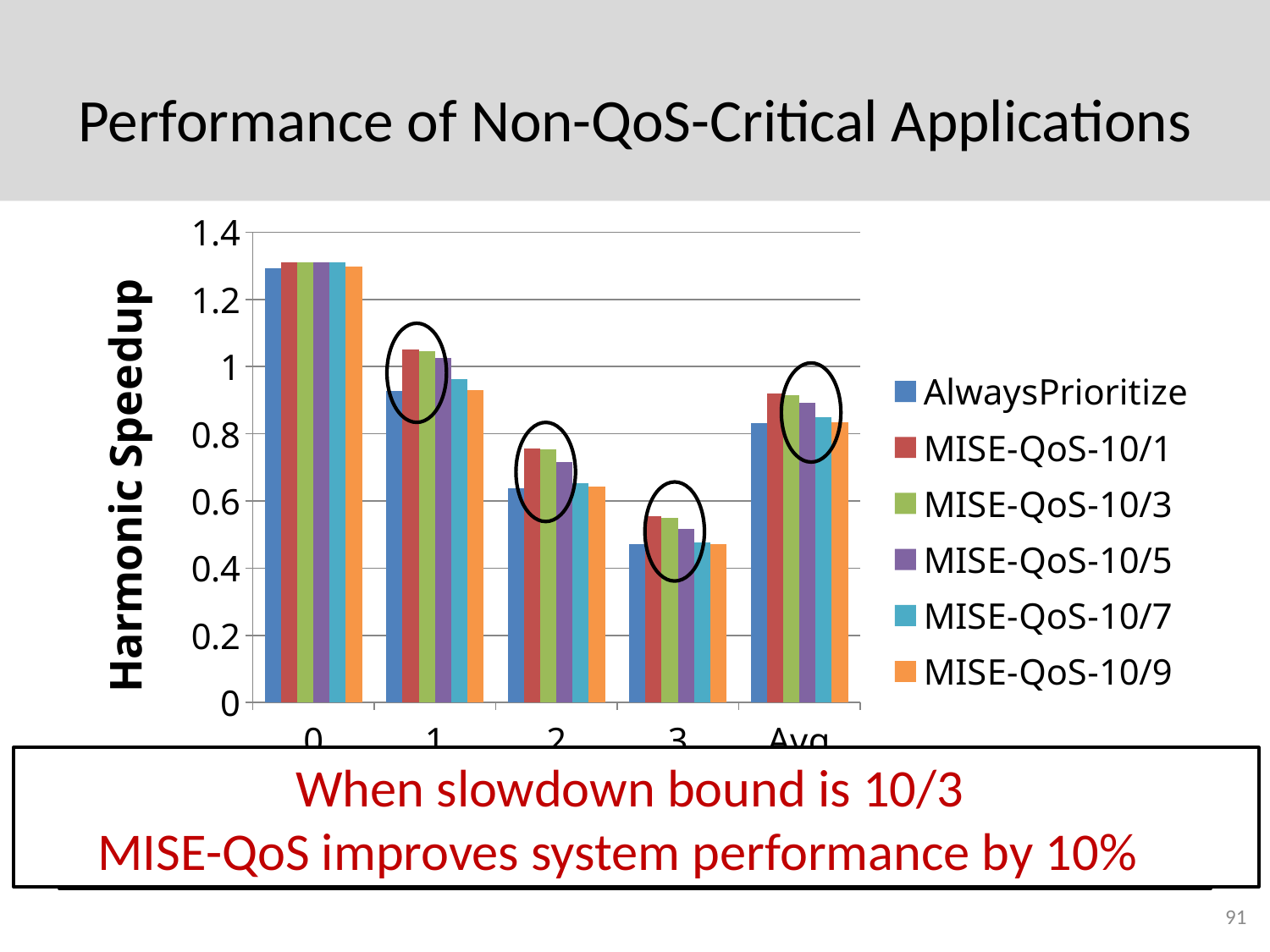
Is the AlwaysPrioritize value for category 0 greater or less than 1.2? greater How many categories are shown along the x axis? 5 Is the MISE-QoS-10/9 value for category 3 greater or less than 0.6? less How many series does the legend list? 6 Is the AlwaysPrioritize value for category 2 greater or less than 0.8? less For the AlwaysPrioritize series, which category has the lowest harmonic speedup? 3 For category 2, which is larger: MISE-QoS-10/1 or AlwaysPrioritize? MISE-QoS-10/1 What kind of chart is shown on the slide? bar chart What is the label of the y axis? Harmonic Speedup For the AlwaysPrioritize series, which category has the highest harmonic speedup? 0 Do the AlwaysPrioritize values rise or fall from category 0 to category 3? fall